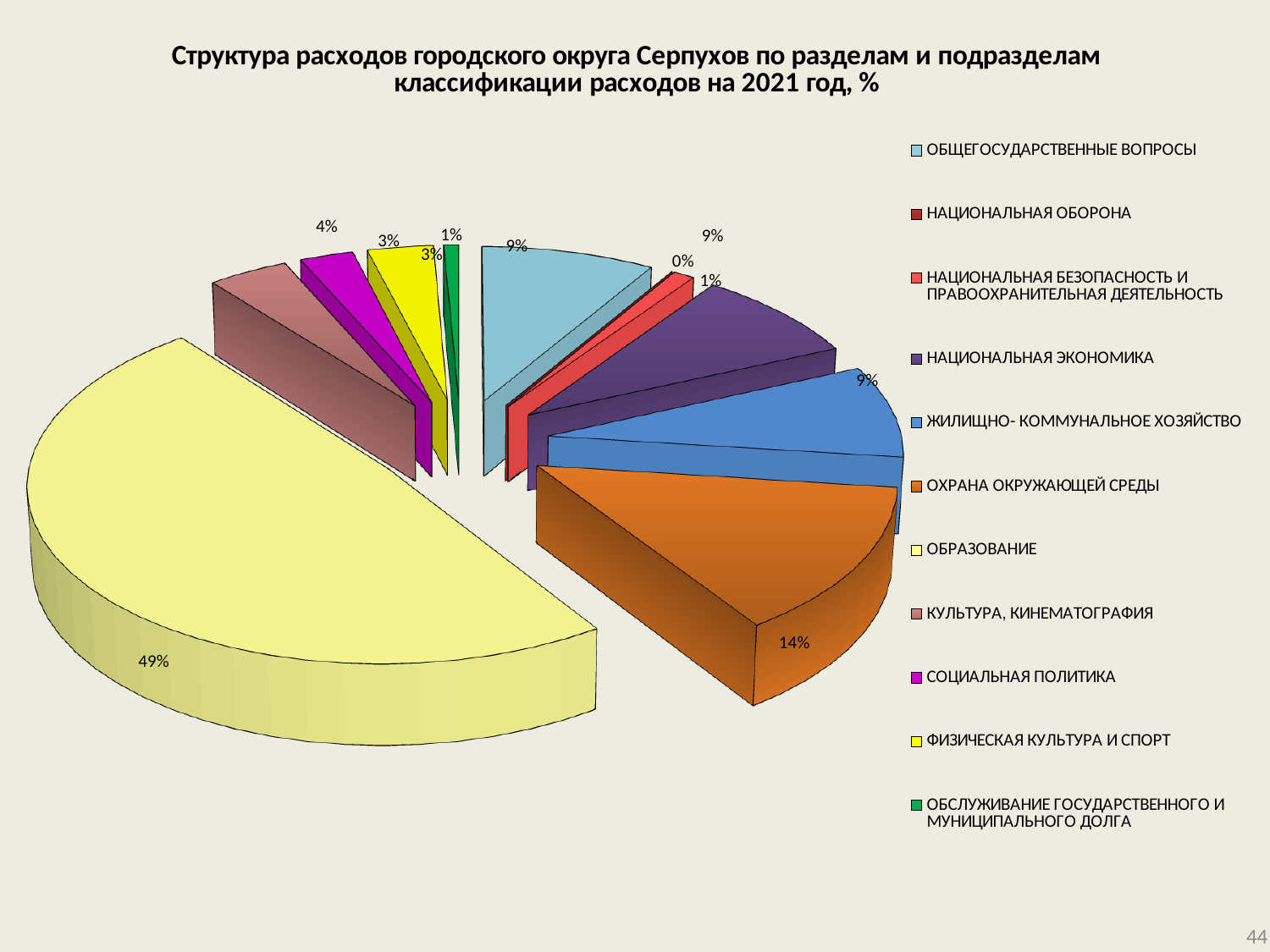
What share of expenditures does НАЦИОНАЛЬНАЯ ОБОРОНА account for? 0% What share of expenditures does ОХРАНА ОКРУЖАЮЩЕЙ СРЕДЫ account for? 14% Which has a larger share: ОХРАНА ОКРУЖАЮЩЕЙ СРЕДЫ or ЖИЛИЩНО- КОММУНАЛЬНОЕ ХОЗЯЙСТВО? ОХРАНА ОКРУЖАЮЩЕЙ СРЕДЫ How many categories does the legend list? 11 Which category has the smallest share of expenditures? НАЦИОНАЛЬНАЯ ОБОРОНА What kind of chart is shown on the slide? pie chart What colour is the slice for ОБРАЗОВАНИЕ? yellow What share of expenditures does ОБСЛУЖИВАНИЕ ГОСУДАРСТВЕННОГО И МУНИЦИПАЛЬНОГО ДОЛГА account for? 1% Which category has the largest share of expenditures? ОБРАЗОВАНИЕ What is the difference in percentage points between ОБРАЗОВАНИЕ and ОХРАНА ОКРУЖАЮЩЕЙ СРЕДЫ? 35 What share of expenditures does ОБРАЗОВАНИЕ account for? 49% What share of expenditures does КУЛЬТУРА, КИНЕМАТОГРАФИЯ account for? 4%